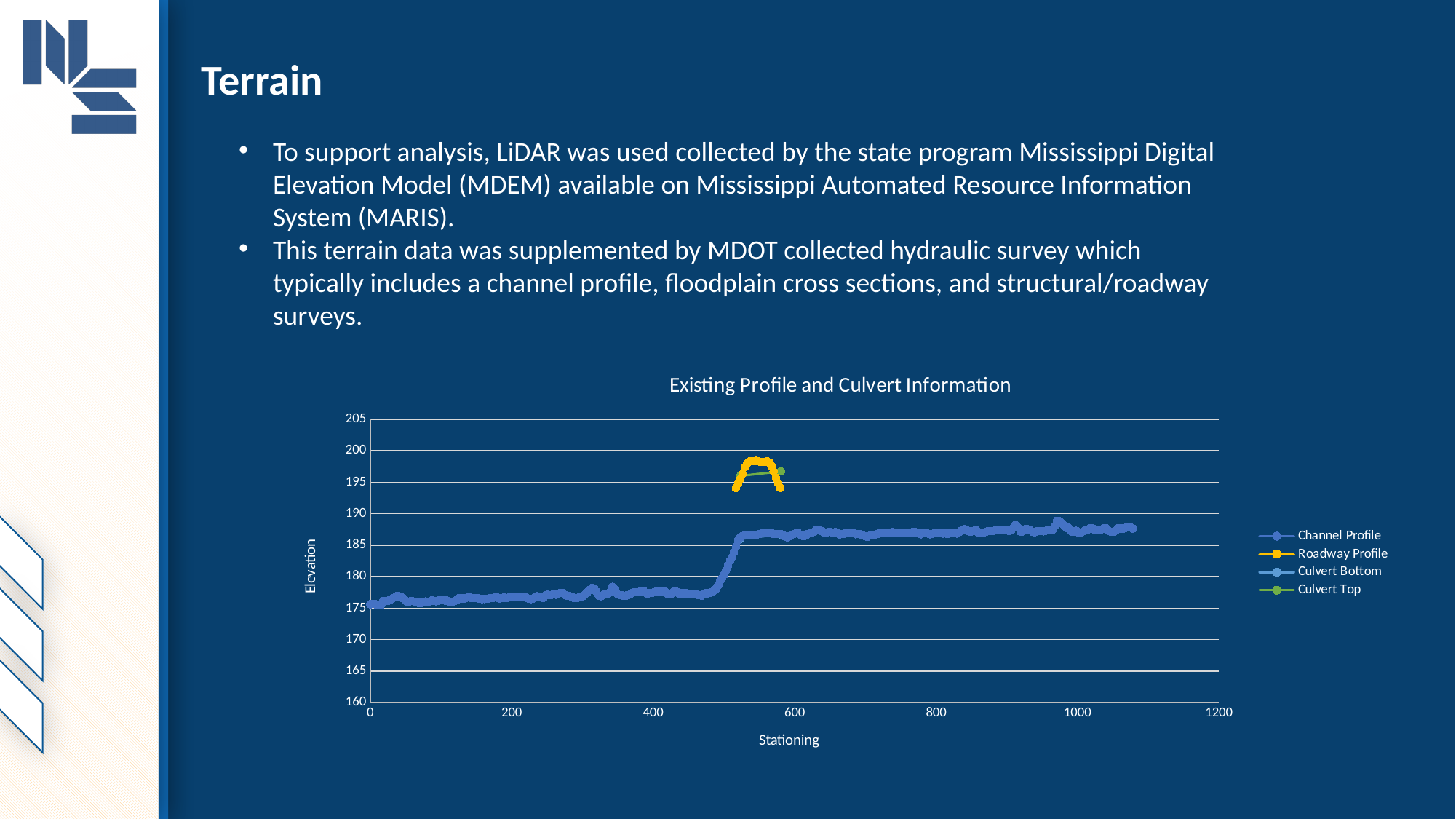
Does the Channel Profile elevation generally rise or fall as stationing increases from 0 to 1000? Rise Which series reaches the highest elevation on the chart, Roadway Profile or Channel Profile? Roadway Profile Is the highest Roadway Profile value greater or less than 200? less What kind of chart is shown on the slide? Line chart Is the Channel Profile value at stationing 600 greater or less than 185? greater Is the Channel Profile value at stationing 1000 greater or less than 185? greater What is the title of the chart? Existing Profile and Culvert Information How many series does the chart legend list? 4 What label is shown on the vertical axis of the chart? Elevation